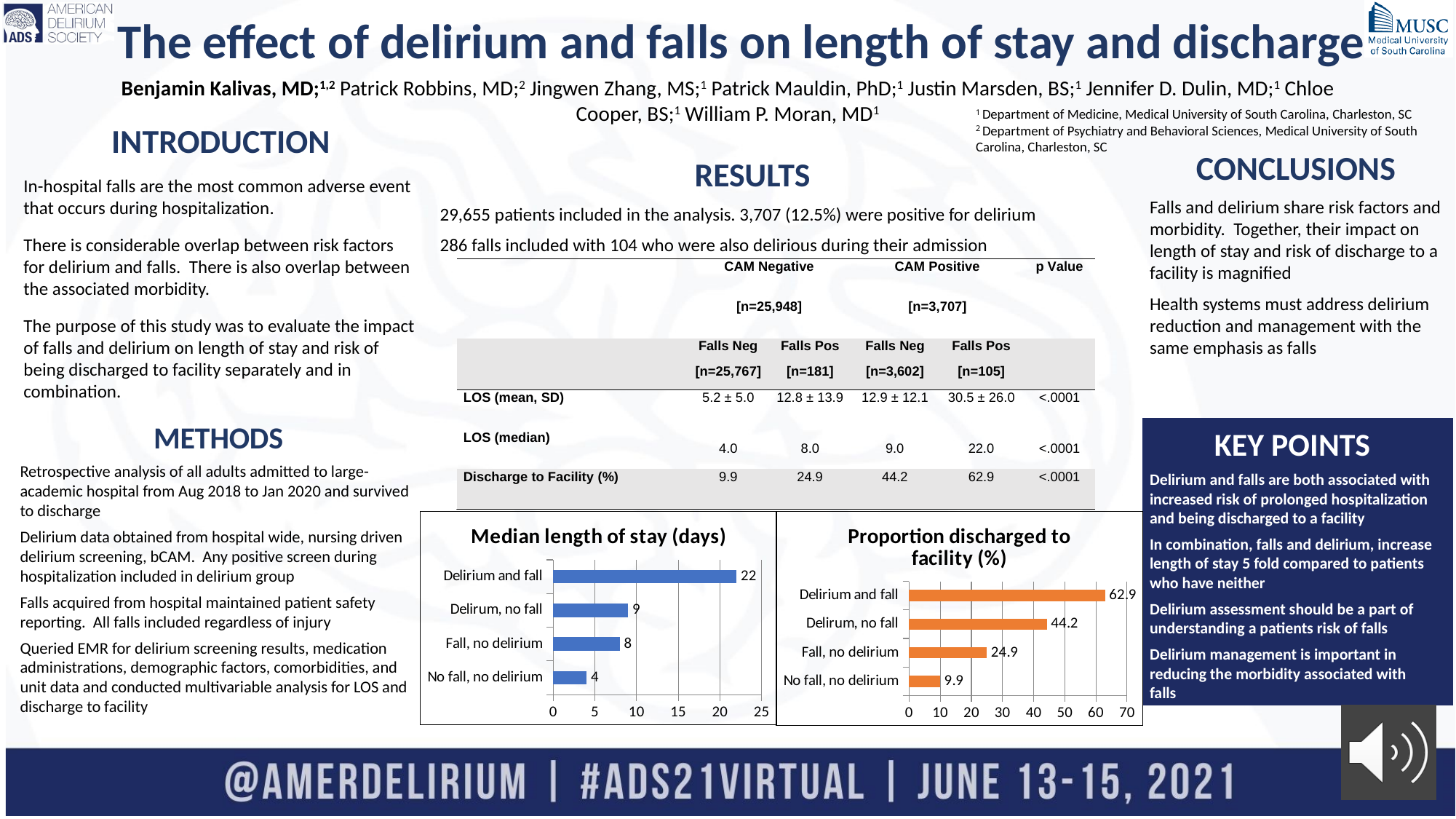
In the 'Proportion discharged to facility (%)' chart, what is the difference between 'Delirium and fall' and 'No fall, no delirium'? 53 In the 'Proportion discharged to facility (%)' chart, which category has the highest value? Delirium and fall In the 'Proportion discharged to facility (%)' chart, is the value for 'Delirium and fall' greater or less than 60? greater What kind of chart is the 'Median length of stay (days)' chart? Bar chart In the 'Median length of stay (days)' chart, how many categories are shown? 4 In the 'Median length of stay (days)' chart, which is larger: 'Delirum, no fall' or 'Fall, no delirium'? Delirum, no fall In the 'Proportion discharged to facility (%)' chart, what is the value for 'Fall, no delirium'? 24.9 In the 'Proportion discharged to facility (%)' chart, what is the value for 'Delirum, no fall'? 44.2 In the 'Median length of stay (days)' chart, which category has the lowest value? No fall, no delirium In the 'Median length of stay (days)' chart, what is the value for 'No fall, no delirium'? 4 In the 'Median length of stay (days)' chart, what is the value for 'Delirium and fall'? 22 In the 'Median length of stay (days)' chart, what is the difference between 'Delirium and fall' and 'Delirum, no fall'? 13